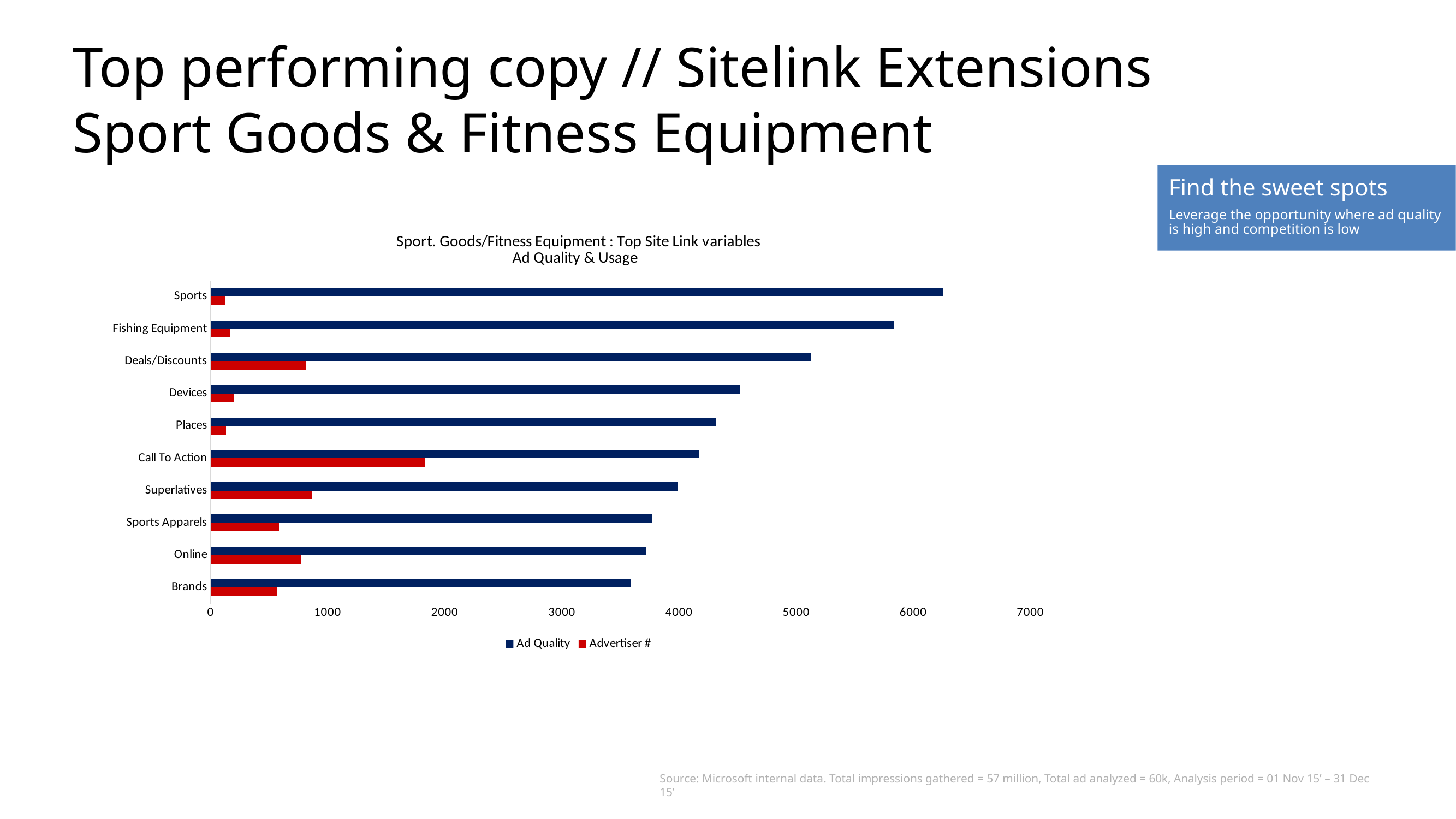
How many categories are plotted on the chart? 10 Which category has the lowest Ad Quality value? Brands Which category has the highest Advertiser # value? Call To Action How many series does the chart legend list? 2 Which series is shown in red in the chart legend? Advertiser # Which category has the highest Ad Quality value? Sports What kind of chart is shown on the slide? Bar chart Is the Ad Quality value for Sports greater or less than 6000? greater Is the Ad Quality value for Deals/Discounts greater or less than 5000? greater Is the Ad Quality value for Brands greater or less than 4000? less Which has the larger Ad Quality value, Fishing Equipment or Deals/Discounts? Fishing Equipment